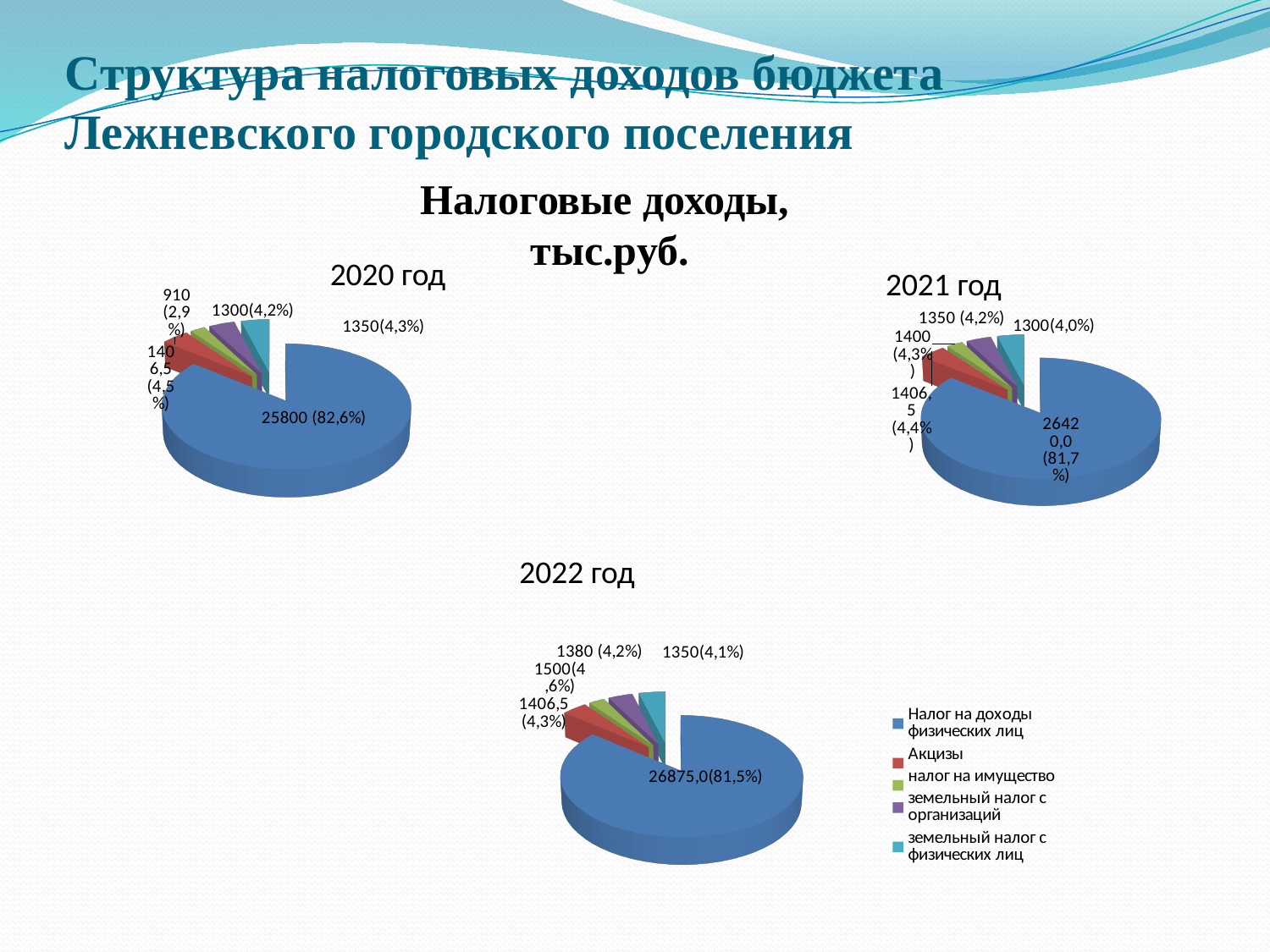
In the 2020 год pie chart, what is the smallest labelled value? 910 (2,9%) In the 2022 год pie chart, what is the value of the largest slice? 26875,0(81,5%) In the 2020 год pie chart, what is the value of the largest slice? 25800 (82,6%) In the 2022 год pie chart, what share of the pie does the slice labelled 1500 have? 4,6% Which is larger: the largest slice in the 2021 год chart or the largest slice in the 2022 год chart? 2022 год (26875,0) What is the common title above the pie charts? Налоговые доходы, тыс.руб. Which legend entry is shown in blue? Налог на доходы физических лиц How many categories does the legend list? 5 What kind of charts are shown on the slide? pie charts What is the difference between the largest slice in the 2022 год chart (26875,0) and the largest slice in the 2020 год chart (25800)? 1075 In the 2021 год pie chart, what share of the pie does the largest slice (Налог на доходы физических лиц) have? 81,7% How many pie charts are on the slide? 3